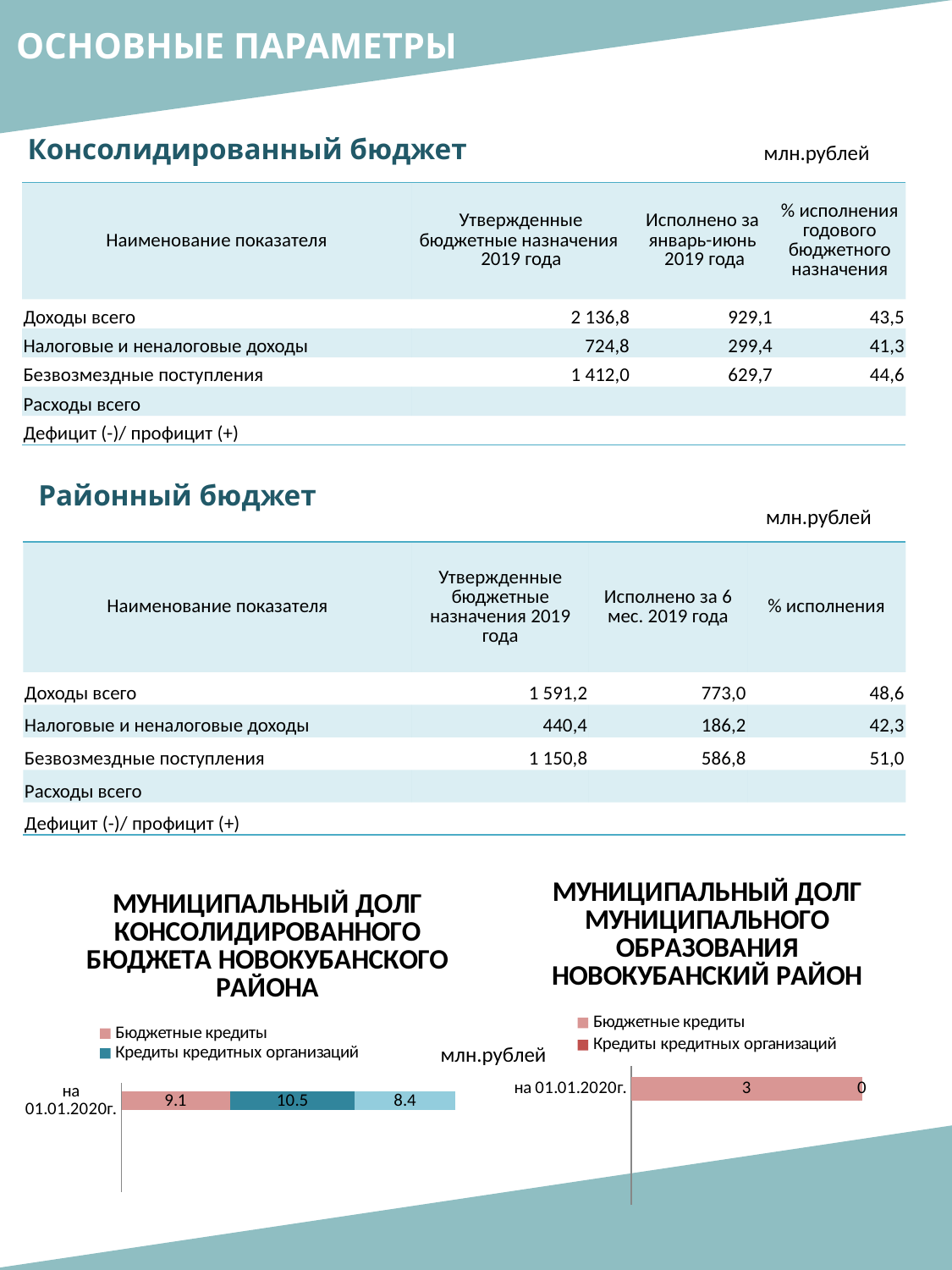
In the left chart (consolidated budget municipal debt), what is the value for Кредиты кредитных организаций? 10.5 What kind of chart is the left chart titled 'МУНИЦИПАЛЬНЫЙ ДОЛГ КОНСОЛИДИРОВАННОГО БЮДЖЕТА НОВОКУБАНСКОГО РАЙОНА'? bar chart In the right chart (municipal debt of the municipal formation Novokubansky district), what is the value for Бюджетные кредиты? 3 In the left chart (consolidated budget municipal debt), what is the difference between Кредиты кредитных организаций and Бюджетные кредиты? 1.4 In the right chart (municipal debt of the municipal formation), what is the total of the stacked bar for 'на 01.01.2020г.'? 3 What kind of chart is the right chart titled 'МУНИЦИПАЛЬНЫЙ ДОЛГ МУНИЦИПАЛЬНОГО ОБРАЗОВАНИЯ НОВОКУБАНСКИЙ РАЙОН'? bar chart What date label is shown on the category axis of the right chart (municipal debt of the municipal formation)? на 01.01.2020г. In the right chart (municipal debt of the municipal formation Novokubansky district), what is the value for Кредиты кредитных организаций? 0 In the left chart (consolidated budget municipal debt), what is the total of the stacked bar for 'на 01.01.2020г.'? 28.0 In the left chart (consolidated budget municipal debt), what is the value for Бюджетные кредиты? 9.1 In the left chart (consolidated budget municipal debt), which is larger: Бюджетные кредиты or Кредиты кредитных организаций? Кредиты кредитных организаций How many series does the legend of the right chart (municipal debt of the municipal formation) list? 2